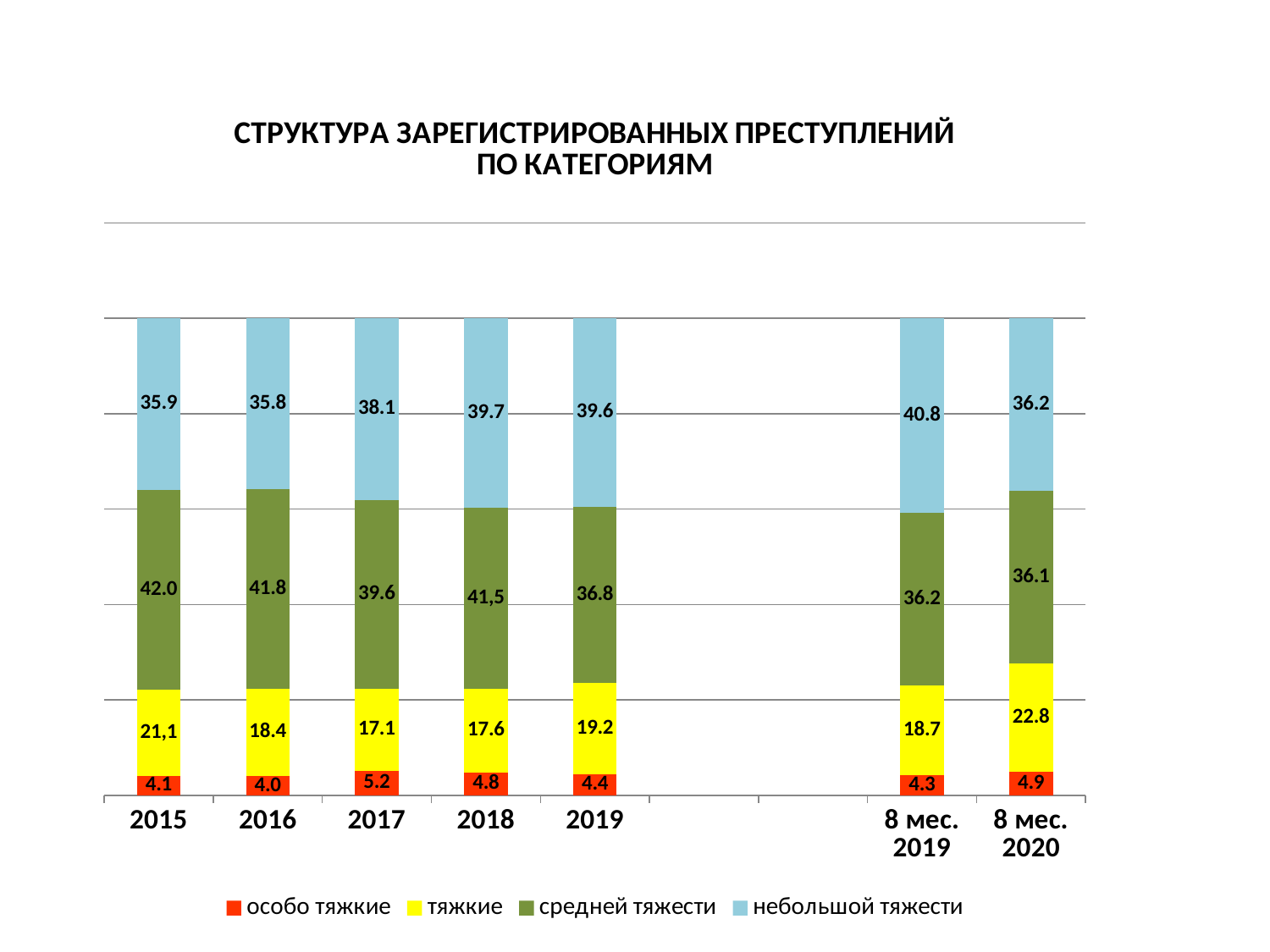
In which category is the value for "тяжкие" the lowest? 2017 What is the value for "небольшой тяжести" in 8 мес. 2019? 40.8 Which is larger: the "небольшой тяжести" value for 2018 or for 2016? 2018 Which series is shown in red in the legend? особо тяжкие What is the value for "особо тяжкие" in 2017? 5.2 What is the value for "тяжкие" in 8 мес. 2020? 22.8 How many series does the legend list? 4 In which category is the value for "особо тяжкие" the highest? 2017 What kind of chart is shown on the slide? Stacked bar chart How many categories are shown on the x axis? 7 What is the difference between the "средней тяжести" values for 2015 and 2019? 5.2 What is the value for "средней тяжести" in 2019? 36.8